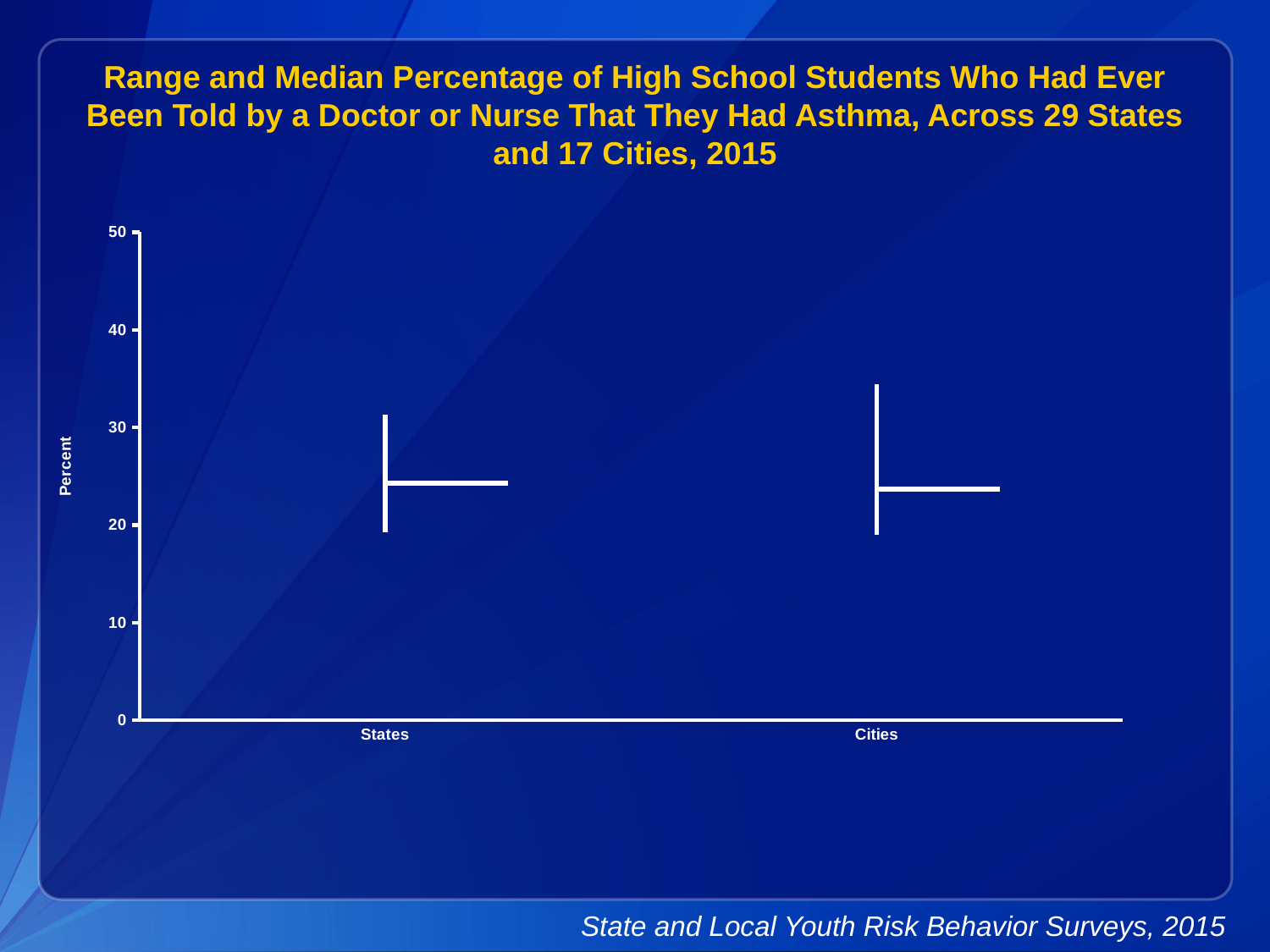
How many categories are shown on the x axis of the chart? 2 Is the top of the range for Cities greater or less than 40? less Is the top of the range for Cities greater or less than 30? greater Is the median value for States greater or less than 30? less What are the two categories shown on the x axis? States and Cities What is the highest value shown on the y axis? 50 Which category has the higher top of its range, States or Cities? Cities What is the label of the y axis? Percent